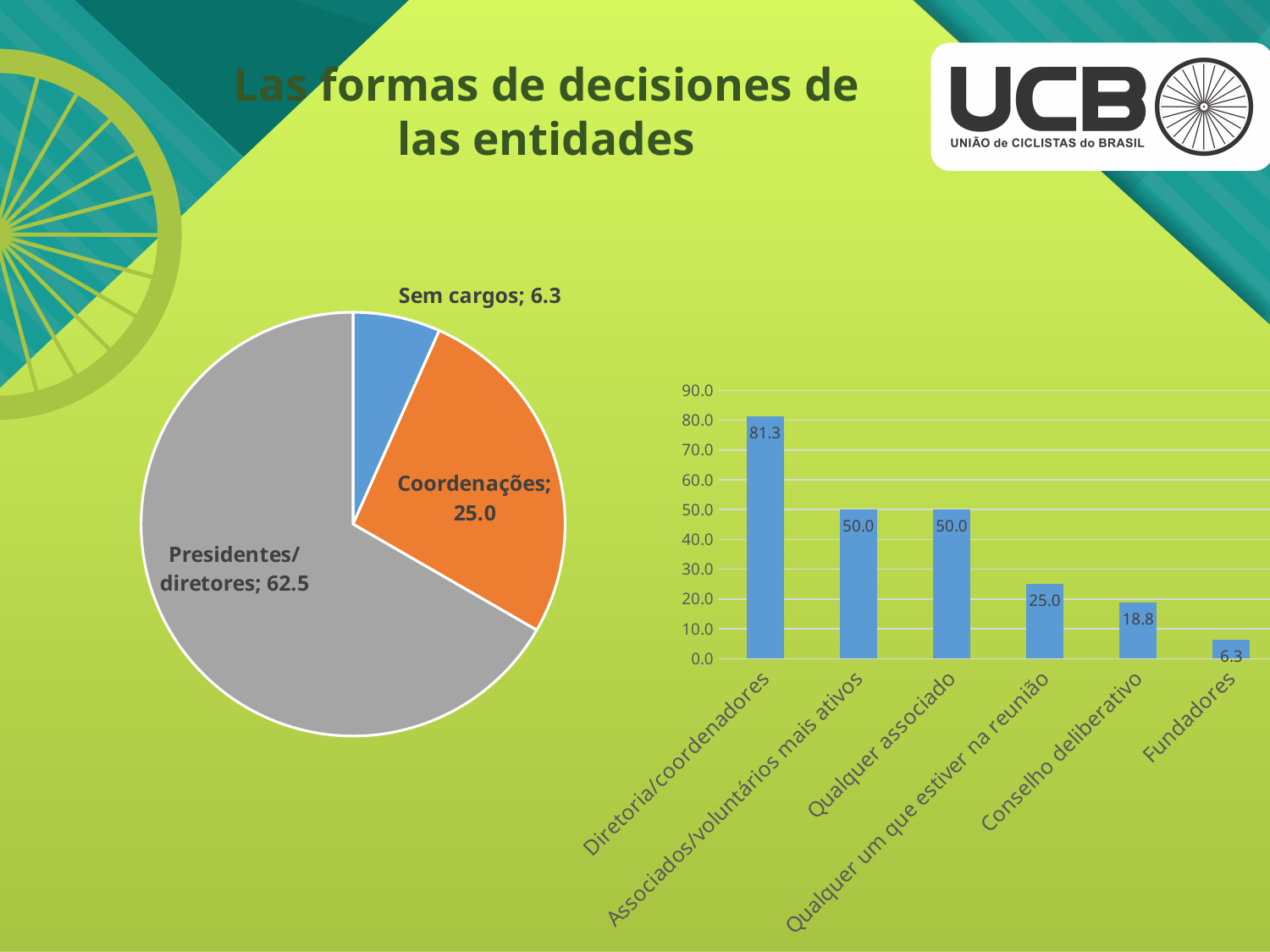
In the pie chart on the left, which slice is the smallest? Sem cargos In the bar chart on the right, how many categories are shown? 6 In the bar chart on the right, what is the value for Diretoria/coordenadores? 81.3 In the bar chart on the right, which category has the lowest value? Fundadores In the bar chart on the right, which is larger: Qualquer um que estiver na reunião or Conselho deliberativo? Qualquer um que estiver na reunião In the pie chart on the left, what is the value for Presidentes/diretores? 62.5 What kind of chart is on the right side of the slide? Bar chart In the pie chart on the left, what is the value for Coordenações? 25.0 In the pie chart on the left, how many slices are there? 3 In the pie chart on the left, what is the difference between the values for Presidentes/diretores and Coordenações? 37.5 In the bar chart on the right, what is the value for Conselho deliberativo? 18.8 In the bar chart on the right, what is the difference between the values for Diretoria/coordenadores and Qualquer associado? 31.3